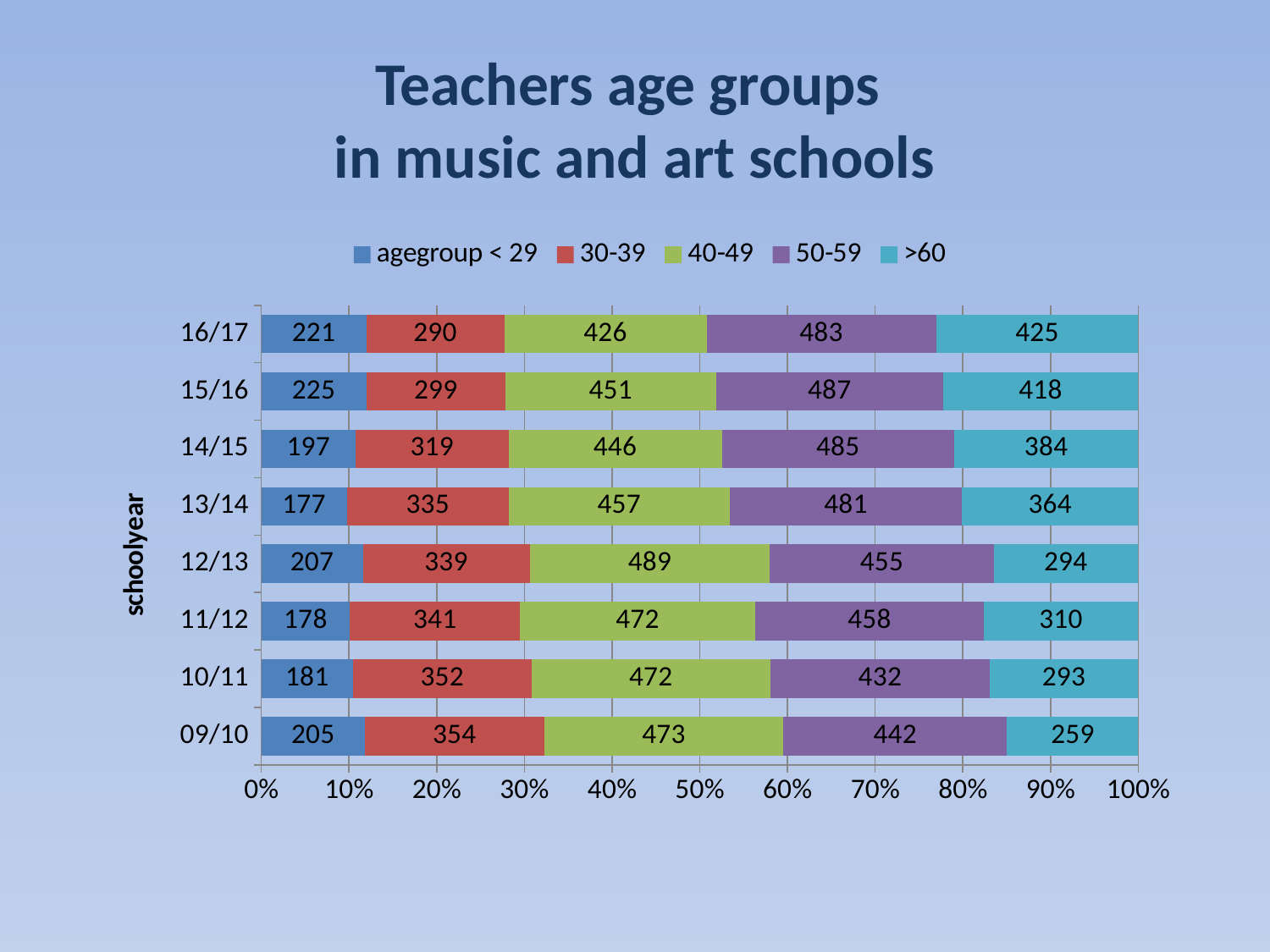
What is the value for the 30-39 age group in school year 14/15? 319 Which school year has the highest value for the >60 age group? 16/17 What is the value for the 40-49 age group in school year 12/13? 489 What is the total number of teachers in school year 16/17 (sum of all age groups)? 1845 Which is larger: the 30-39 value in 09/10 or the 30-39 value in 16/17? 09/10 What is the label of the vertical axis? schoolyear How many school years are shown on the chart? 8 How many series does the legend list? 5 What is the difference between the 50-59 values for school years 15/16 and 09/10? 45 What is the value for the >60 age group in school year 09/10? 259 Which school year has the lowest value for the agegroup < 29 series? 13/14 What kind of chart is shown on the slide? Stacked bar chart